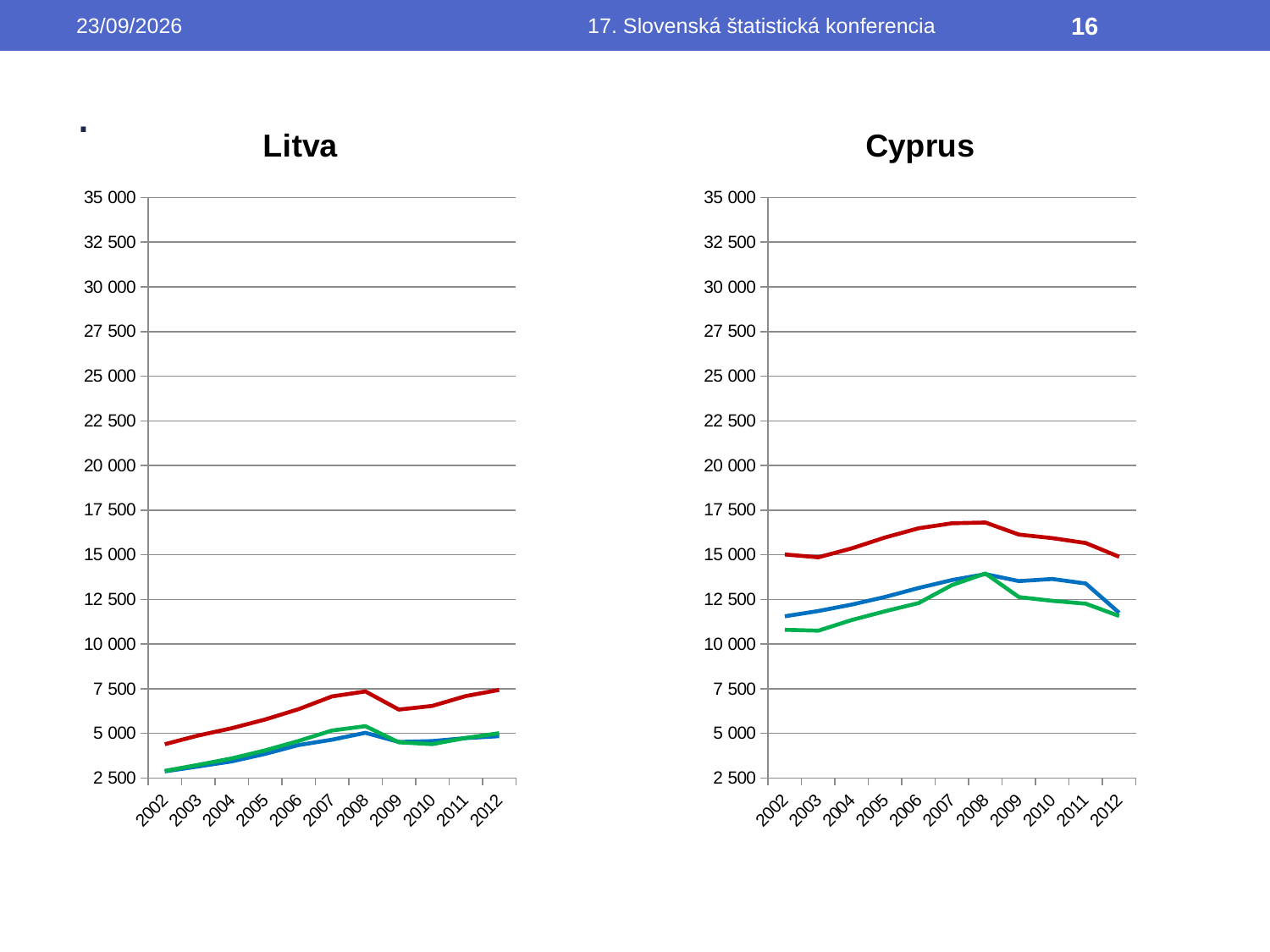
In the Litva chart, is the value of the red line in 2002 greater or less than 5 000? less What are the titles of the two charts on the slide? Litva and Cyprus Which chart has the higher value for the red line in 2002, Litva or Cyprus? Cyprus What type of chart is the Litva chart? line chart In the Litva chart, how many lines are plotted? 3 In the Litva chart, is the value of the red line in 2009 greater or less than 5 000? greater In the Cyprus chart, how many years are shown on the x axis? 11 In the Litva chart, does the red line rise or fall from 2002 to 2008? rise In the Litva chart, in which year is the red line at its lowest value? 2002 In the Cyprus chart, in which year does the red line reach its highest value? 2008 In the Cyprus chart, is the value of the blue line in 2012 greater or less than 12 500? less